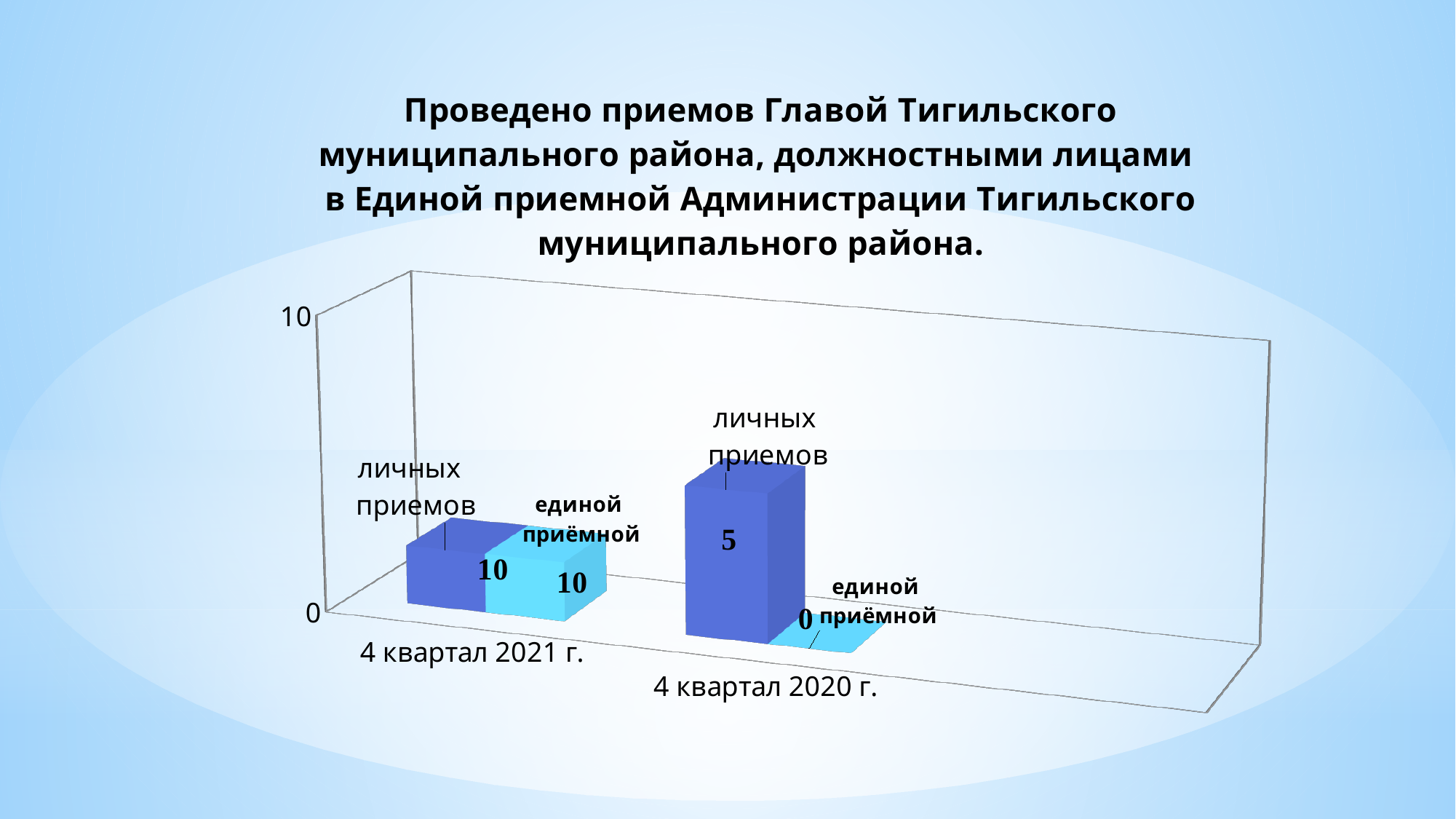
What is the value for единой приёмной in 4 квартал 2021 г.? 10 How many periods (categories) are shown on the x axis? 2 What is the difference between личных приемов in 4 квартал 2021 г. and in 4 квартал 2020 г.? 5 Which bar has the lowest value on the chart? единой приёмной in 4 квартал 2020 г. How many личных приемов were held in 4 квартал 2020 г.? 5 What is the difference between единой приёмной in 4 квартал 2021 г. and in 4 квартал 2020 г.? 10 How many личных приемов were held in 4 квартал 2021 г.? 10 What is the value for единой приёмной in 4 квартал 2020 г.? 0 What kind of chart is shown on the slide? bar chart